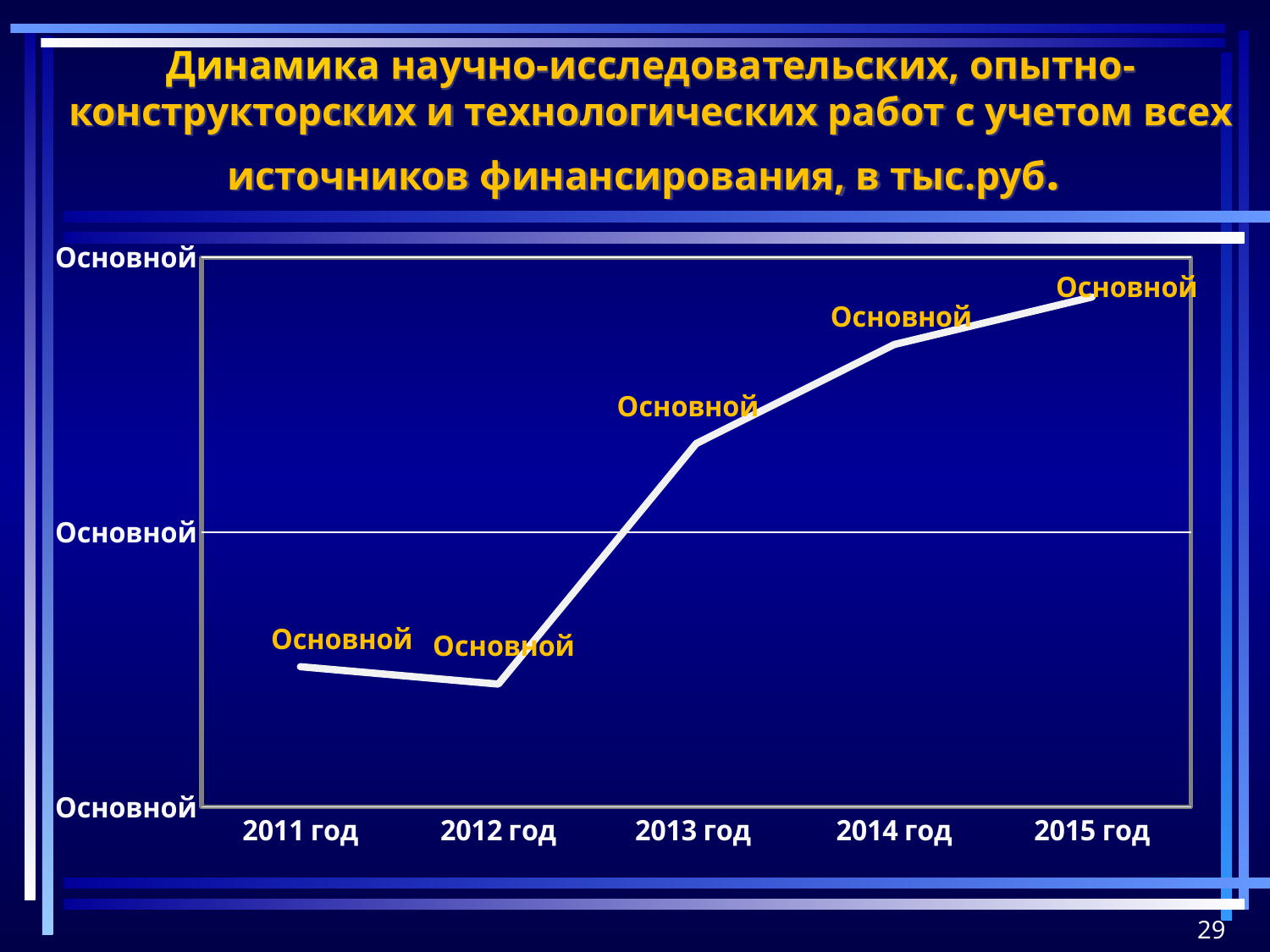
In what units does the chart title say the values are given? тыс.руб. Which is larger, the value for 2011 год or the value for 2013 год? 2013 год Do the values rise or fall from 2011 год to 2012 год? fall Which year has the lowest value on the chart? 2012 год What kind of chart is shown on the slide? line chart How many years are plotted along the x axis of the chart? 5 Do the values rise or fall from 2012 год to 2015 год? rise Which year has the highest value on the chart? 2015 год What is the first year shown on the x axis of the chart? 2011 год Which is larger, the value for 2014 год or the value for 2015 год? 2015 год Which is larger, the value for 2013 год or the value for 2012 год? 2013 год